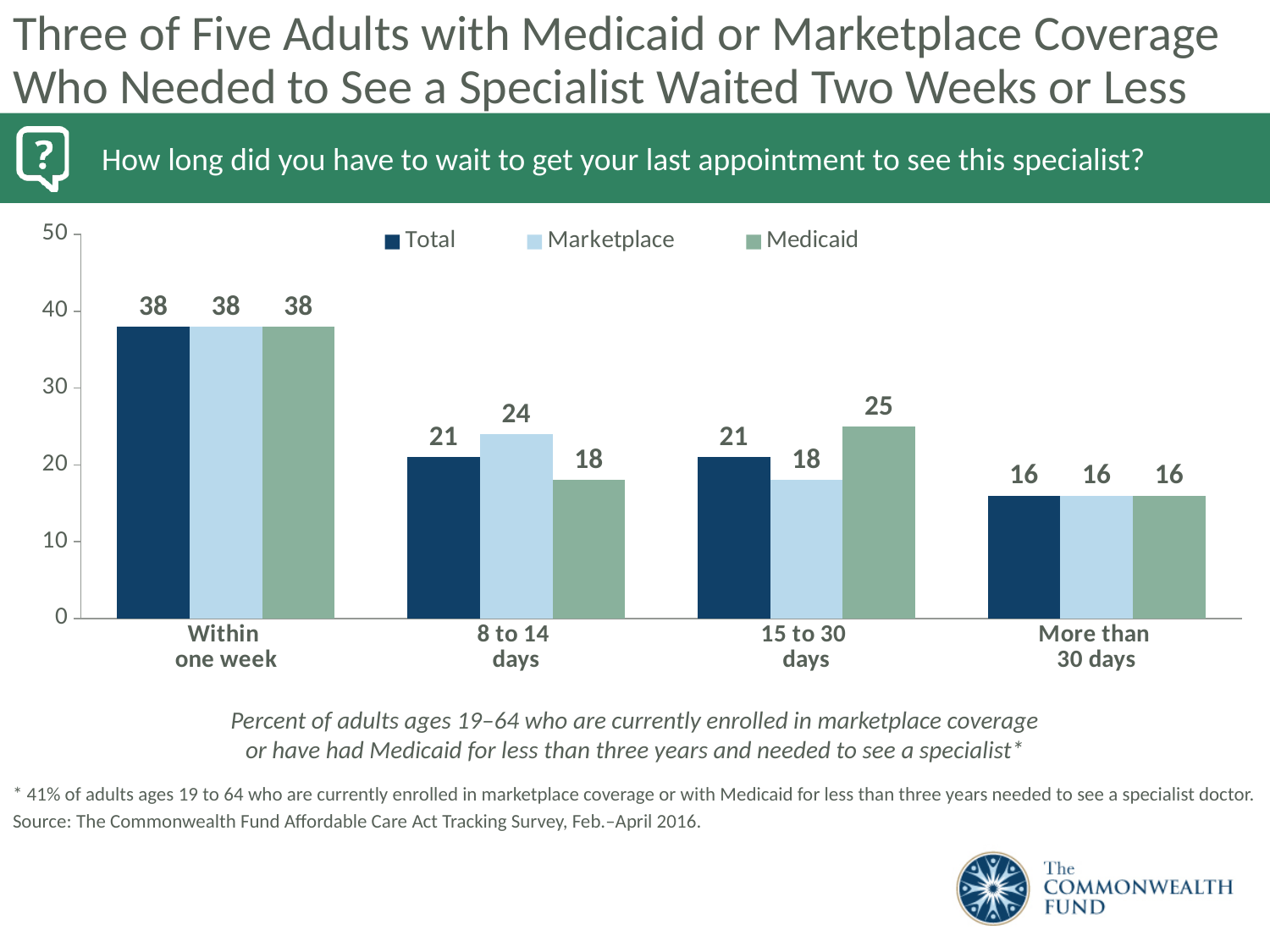
How many series does the legend list? 3 What is the Total value for the 'More than 30 days' category? 16 What is the Medicaid value for the '15 to 30 days' category? 25 How many categories are shown on the x axis? 4 What kind of chart is shown on the slide? Bar chart For '15 to 30 days', which is larger: the Marketplace value or the Medicaid value? Medicaid What are the three series listed in the legend? Total, Marketplace, Medicaid What is the difference between the Marketplace and Medicaid values for '8 to 14 days'? 6 Do the Total values rise or fall from 'Within one week' to 'More than 30 days'? Fall What is the Marketplace value for the '8 to 14 days' category? 24 Which category has the highest Total value? Within one week Which category has the lowest Medicaid value? More than 30 days